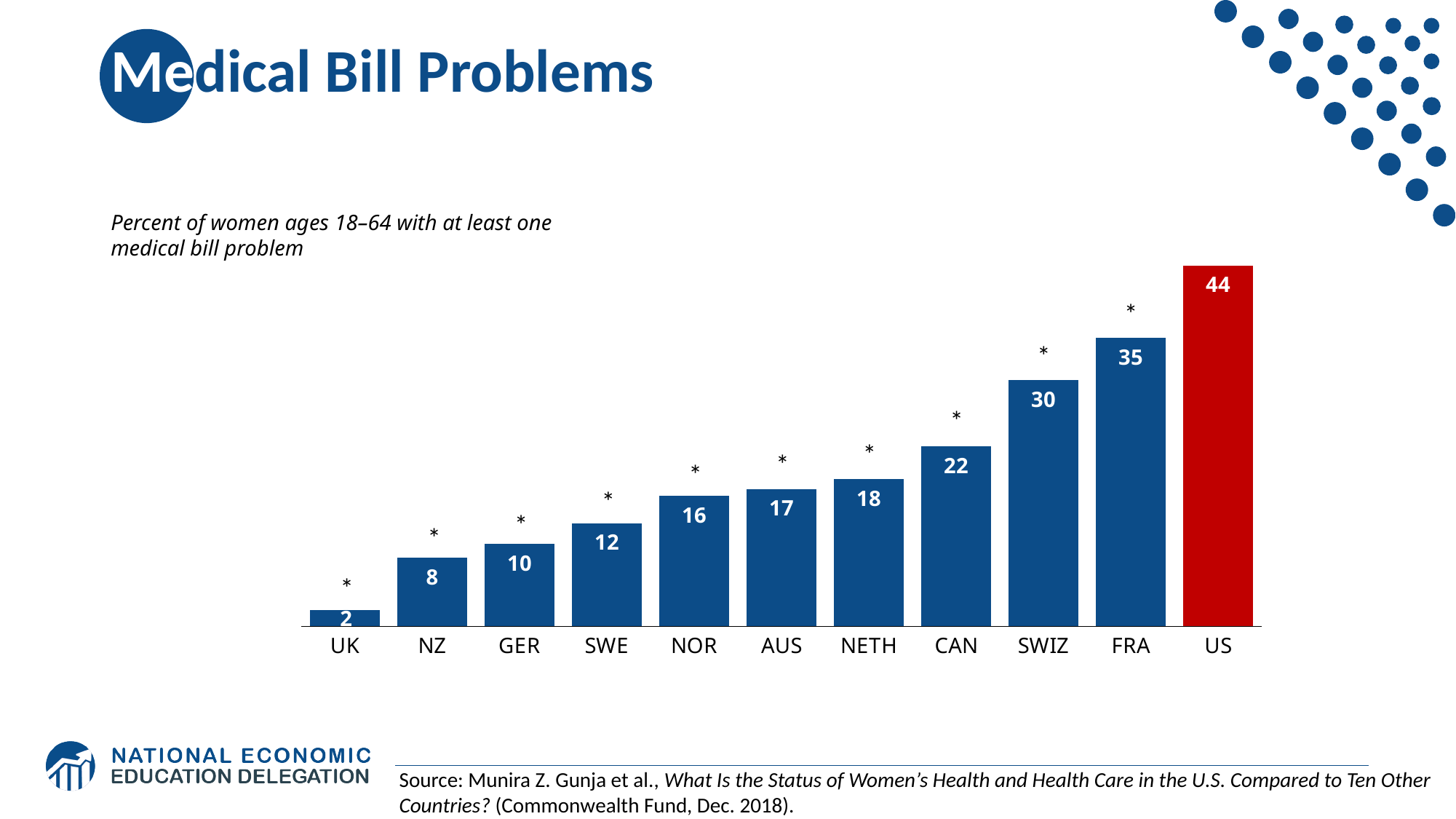
What is the difference between the values for the US and France (FRA)? 9 What kind of chart is shown on the slide? Bar chart Which has a larger value, Norway (NOR) or Sweden (SWE)? NOR Which country has the lowest value? UK What is the difference between the values for Switzerland (SWIZ) and the UK? 28 How many countries are shown in the chart? 11 What is the value for Canada (CAN)? 22 What is the value for the US? 44 Which country has the highest value? US Do the values rise or fall from left to right along the x axis? Rise What is the value for Germany (GER)? 10 Which country's bar is coloured red rather than blue? US